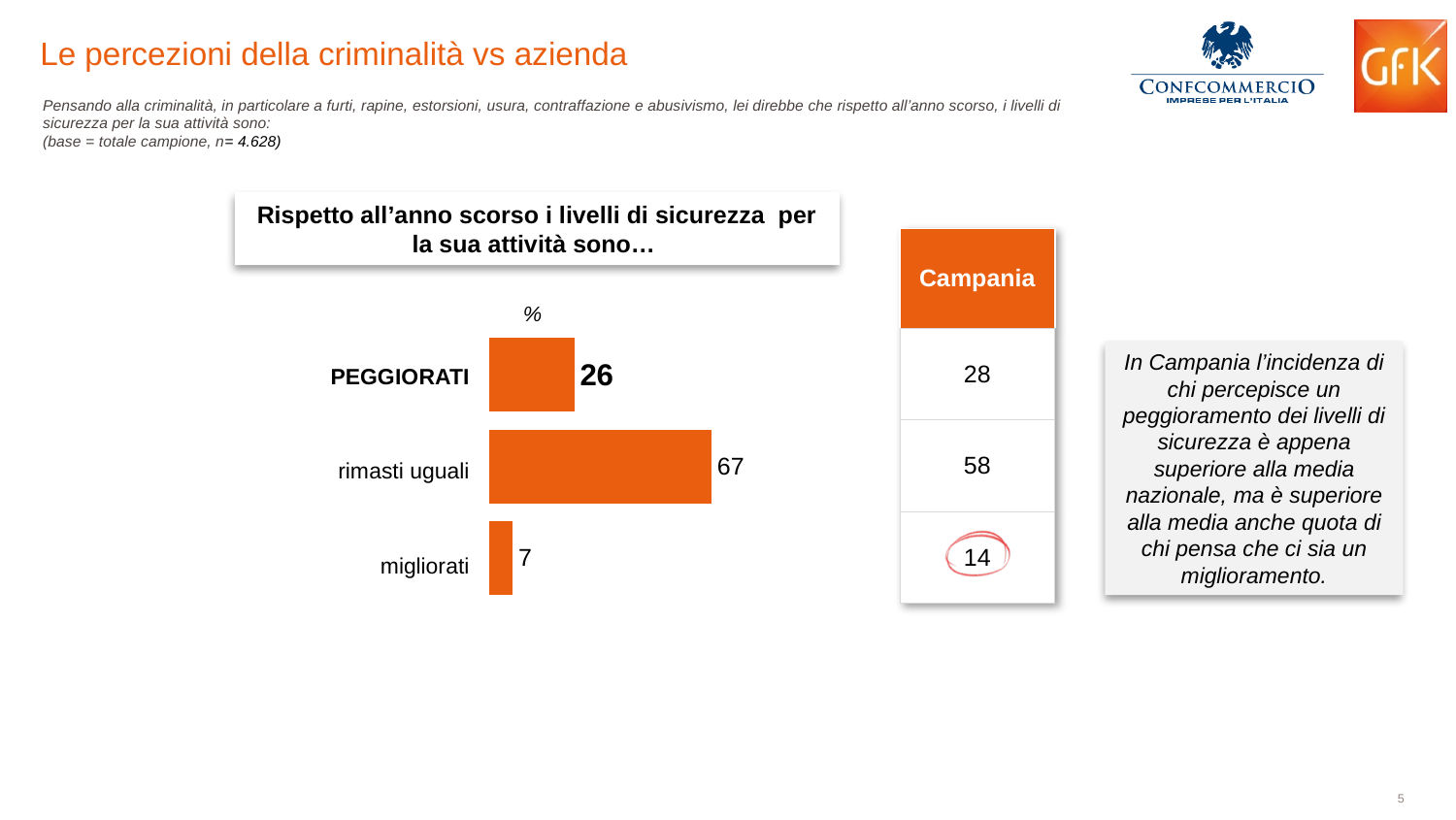
Which category has the highest value in the bar chart? rimasti uguali What unit is indicated above the bars in the chart? % What kind of chart is shown on the slide? bar chart What is the value for PEGGIORATI in the bar chart? 26 What is the difference between the values for PEGGIORATI and migliorati? 19 What is the total of the three values shown in the bar chart? 100 What is the value for migliorati in the bar chart? 7 What is the value for rimasti uguali in the bar chart? 67 Which category has the lowest value in the bar chart? migliorati Which is larger, the value for PEGGIORATI or the value for migliorati? PEGGIORATI How many categories are shown in the bar chart? 3 What is the difference between the values for rimasti uguali and PEGGIORATI? 41